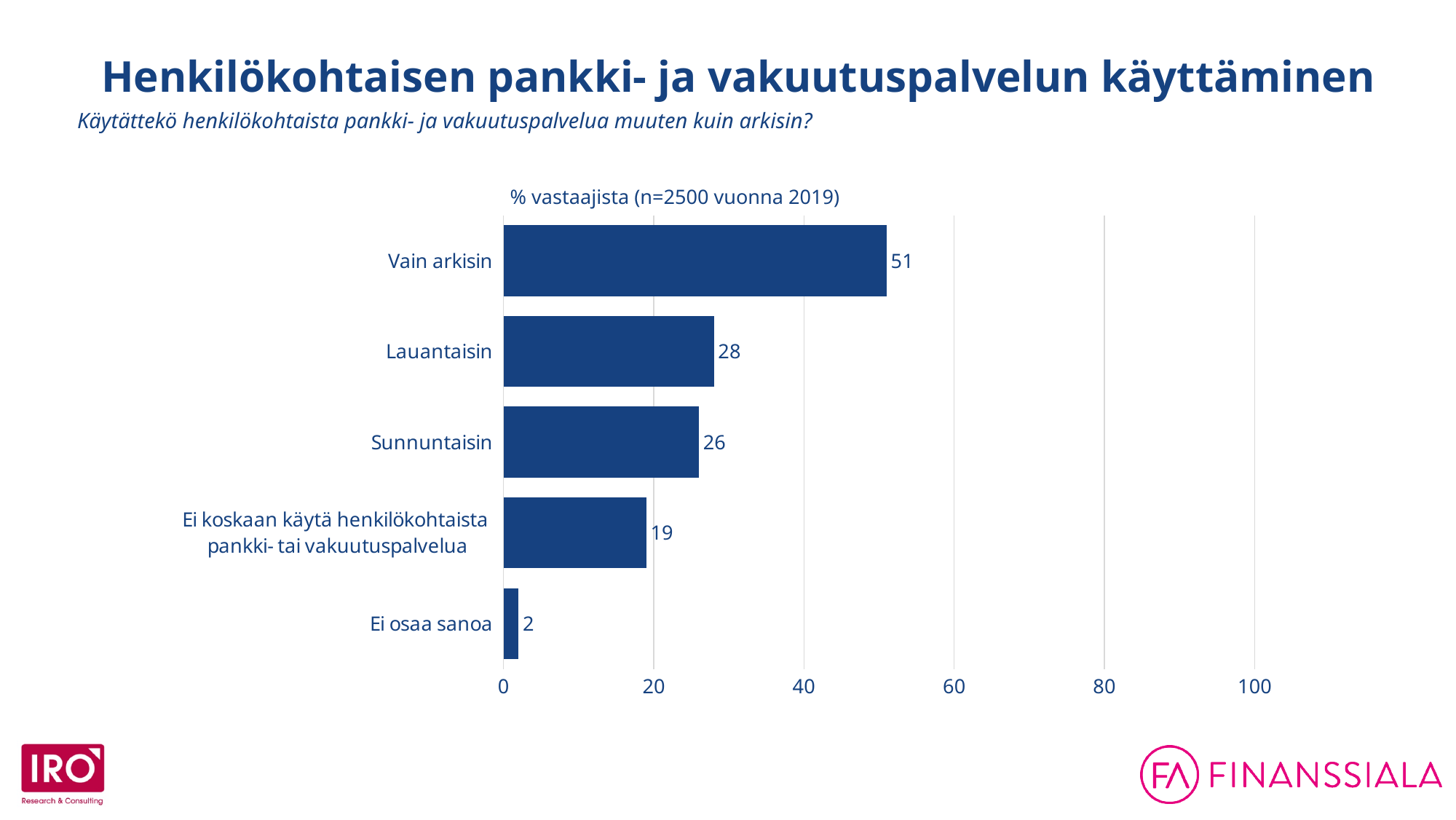
What is the title of the chart? % vastaajista (n=2500 vuonna 2019) Which is larger, the value for Lauantaisin or the value for Sunnuntaisin? Lauantaisin What is the value for Lauantaisin? 28 Which category has the highest value? Vain arkisin What is the value for Vain arkisin? 51 What is the value for Sunnuntaisin? 26 What is the value for Ei osaa sanoa? 2 What is the value for Ei koskaan käytä henkilökohtaista pankki- tai vakuutuspalvelua? 19 How many categories are shown in the chart? 5 What is the difference between the values for Vain arkisin and Lauantaisin? 23 What kind of chart is shown on the slide? Bar chart Which category has the lowest value? Ei osaa sanoa